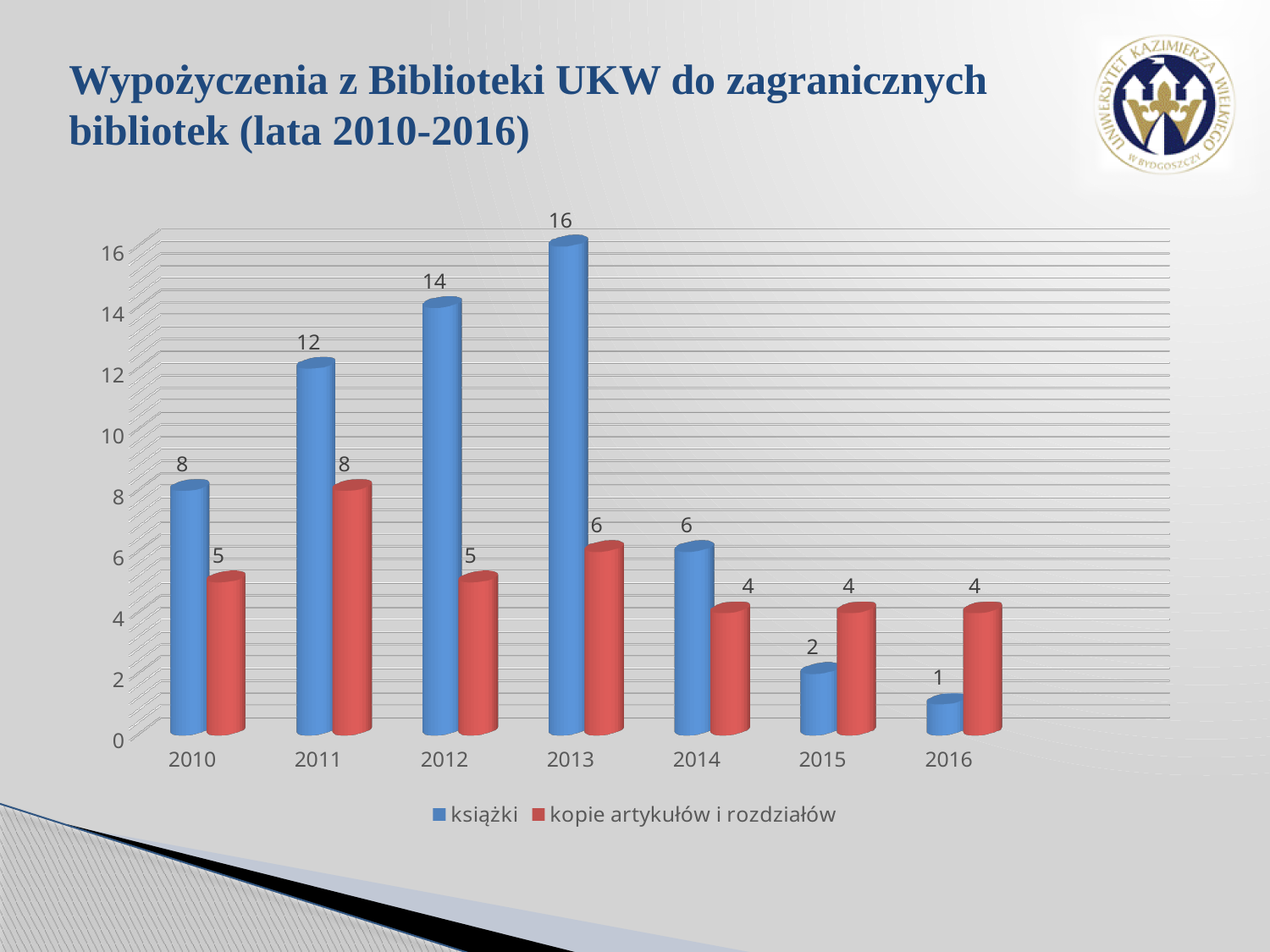
What kind of chart is shown on the slide? bar chart Do the values for książki rise or fall from 2013 to 2016? fall What is the value for kopie artykułów i rozdziałów in 2011? 8 Which is larger in 2015, książki or kopie artykułów i rozdziałów? kopie artykułów i rozdziałów What is the difference between książki and kopie artykułów i rozdziałów in 2012? 9 How many years are shown on the x axis? 7 Which year has the highest value for książki? 2013 Which year has the lowest value for książki? 2016 How many series does the legend list? 2 What is the value for książki in 2016? 1 What is the value for książki in 2013? 16 What colour are the bars for kopie artykułów i rozdziałów? red